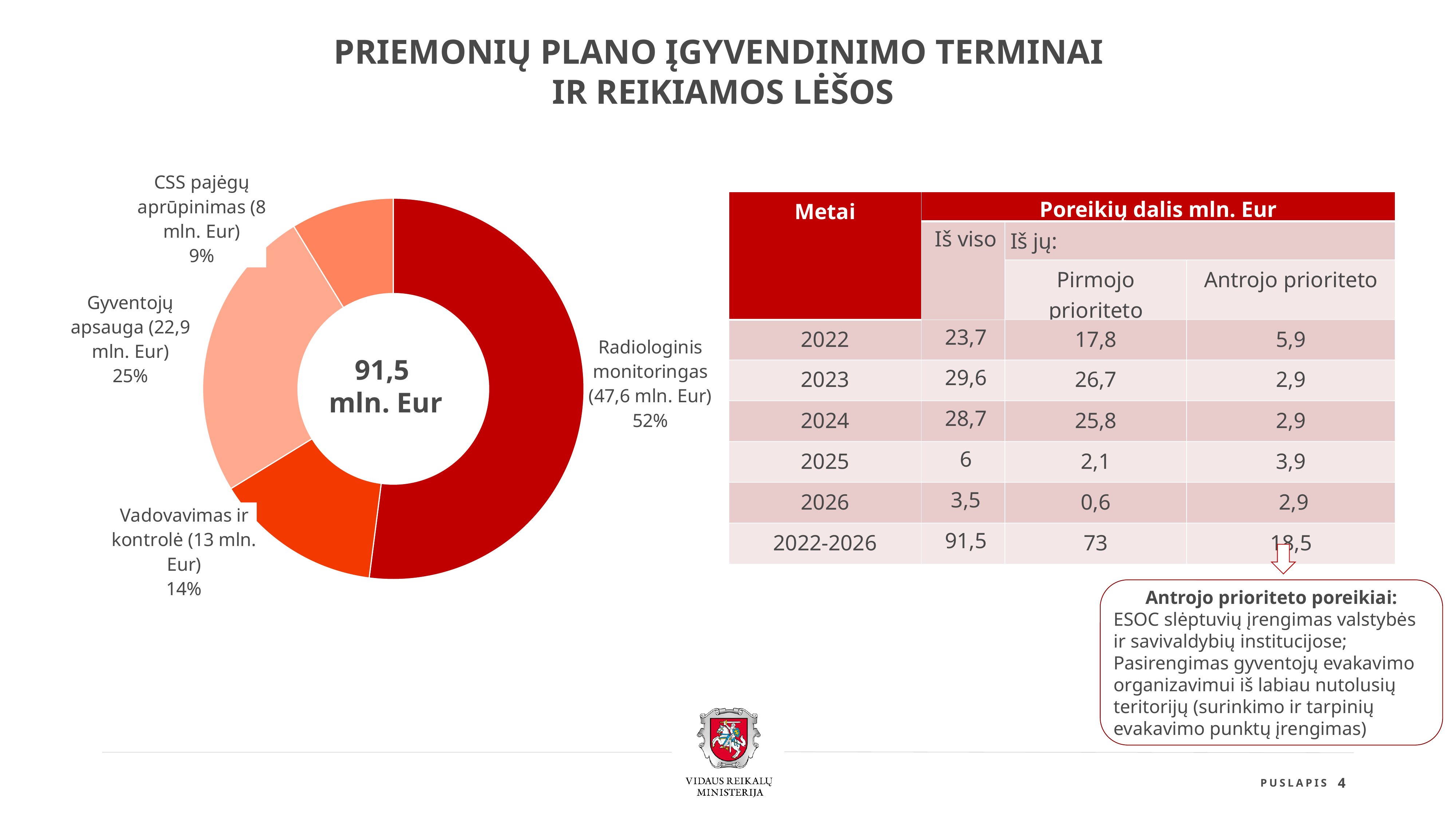
What value in mln. Eur is shown for CSS pajėgų aprūpinimas in the donut chart? 8 mln. Eur How many slices does the donut chart have? 4 What percentage is shown for Vadovavimas ir kontrolė in the donut chart? 14% What total value is printed in the centre of the donut chart? 91,5 mln. Eur What kind of chart is shown on the left of the slide? Donut (pie) chart Which category has the smallest slice in the donut chart? CSS pajėgų aprūpinimas What share of the donut chart does Radiologinis monitoringas take? 52% Which is larger in the donut chart: Gyventojų apsauga or Vadovavimas ir kontrolė? Gyventojų apsauga What value in mln. Eur is shown for Gyventojų apsauga in the donut chart? 22,9 mln. Eur What colour is the Radiologinis monitoringas slice in the donut chart? Dark red What is the difference in percentage points between the Radiologinis monitoringas slice and the Gyventojų apsauga slice? 27 percentage points Which category has the largest slice in the donut chart? Radiologinis monitoringas